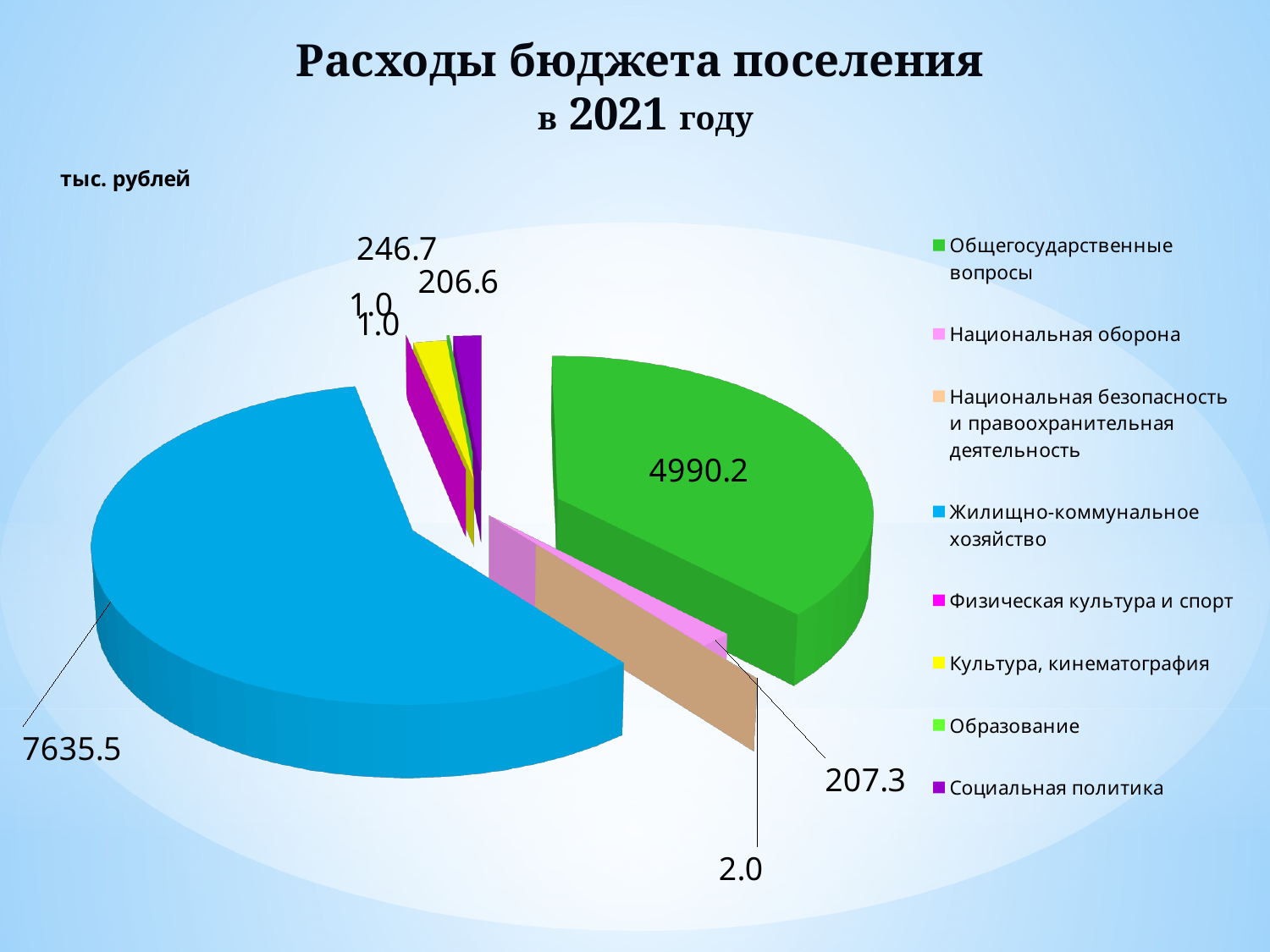
What is the value for Общегосударственные вопросы? 4990.2 What is the difference between Общегосударственные вопросы and Национальная безопасность и правоохранительная деятельность? 4988.2 In what units are the values given? тыс. рублей What is the title of the chart? Расходы бюджета поселения в 2021 году Which category has the largest share of the pie? Жилищно-коммунальное хозяйство What is the value for Жилищно-коммунальное хозяйство? 7635.5 What is the value for Национальная оборона? 207.3 What is the difference between Жилищно-коммунальное хозяйство and Общегосударственные вопросы? 2645.3 What kind of chart is shown on the slide? Pie chart How many categories does the legend list? 8 Which is larger, Общегосударственные вопросы or Национальная оборона? Общегосударственные вопросы What is the value for Национальная безопасность и правоохранительная деятельность? 2.0